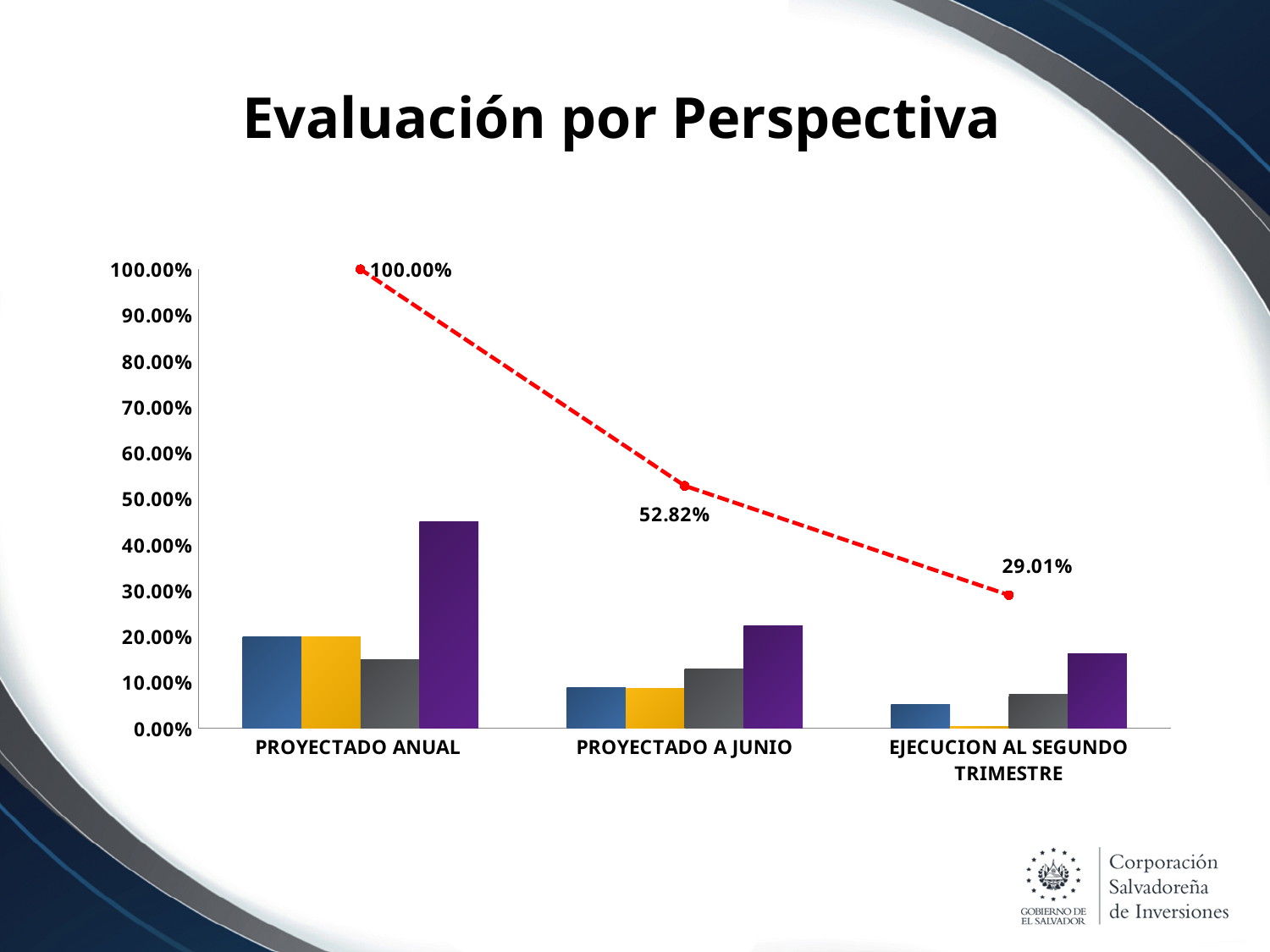
What value does the dashed red line show for PROYECTADO A JUNIO? 52.82% What is the difference between the dashed red line values for PROYECTADO ANUAL and PROYECTADO A JUNIO? 47.18% Which category has the highest value on the dashed red line? PROYECTADO ANUAL Do the values of the dashed red line rise or fall from left to right across the categories? fall Which category has the lowest value on the dashed red line? EJECUCION AL SEGUNDO TRIMESTRE What is the difference between the dashed red line values for PROYECTADO A JUNIO and EJECUCION AL SEGUNDO TRIMESTRE? 23.81% What value does the dashed red line show for EJECUCION AL SEGUNDO TRIMESTRE? 29.01% What value does the dashed red line show for PROYECTADO ANUAL? 100.00% Is the value of the yellow bar for EJECUCION AL SEGUNDO TRIMESTRE greater or less than 10.00%? less Is the value of the purple bar for PROYECTADO ANUAL greater or less than 40.00%? greater What is the title of the chart on the slide? Evaluación por Perspectiva How many categories are shown on the x axis of the chart? 3